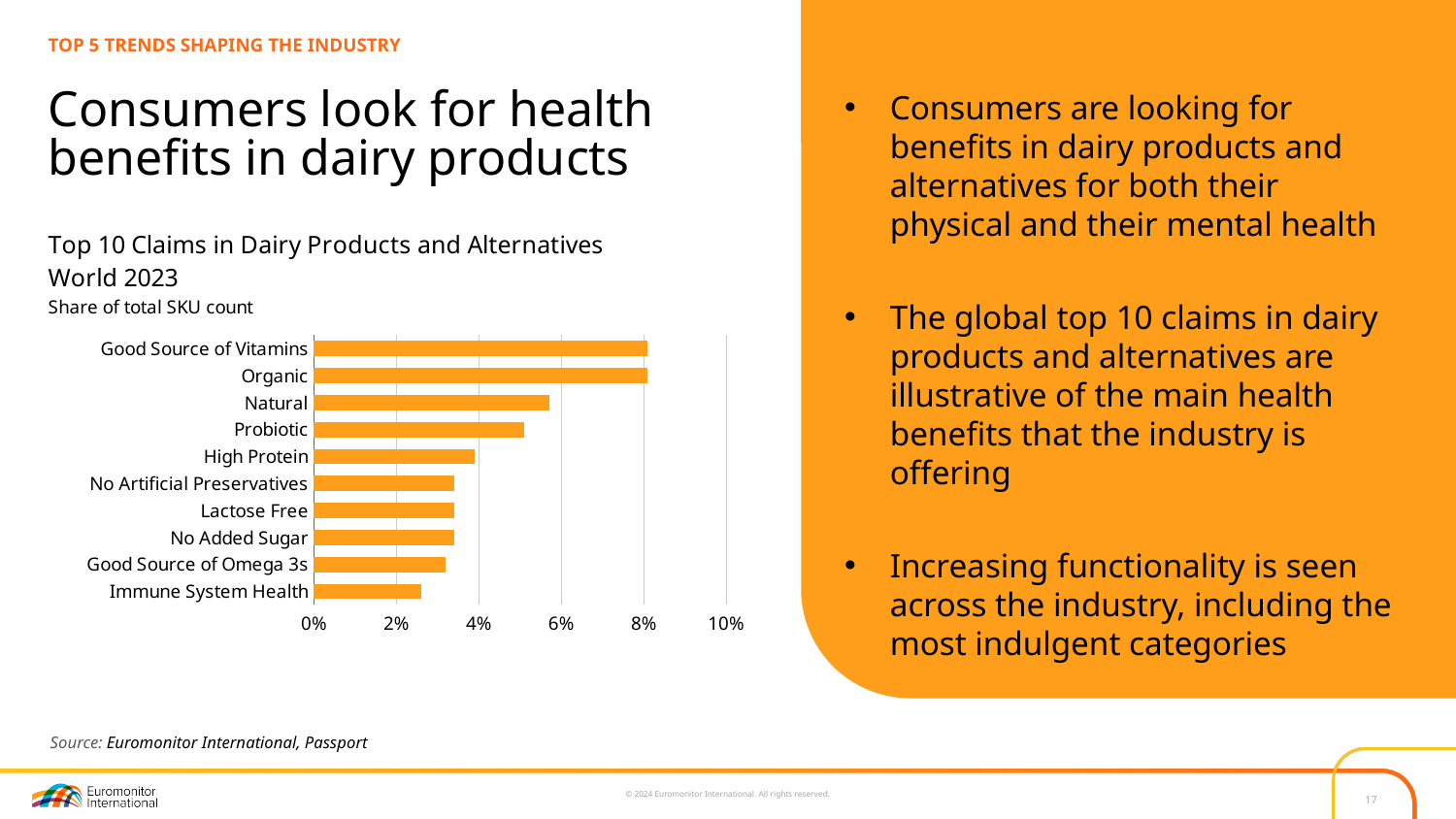
Which claim has the lowest share of total SKU count? Immune System Health Is the value for Probiotic greater or less than 6%? less Is the value for Natural greater or less than 4%? greater Is the value for Lactose Free greater or less than 2%? greater What kind of chart is shown on the slide? Bar chart What is the title of the chart? Top 10 Claims in Dairy Products and Alternatives World 2023 What measure does the chart's subtitle say the bars represent? Share of total SKU count Which has a larger share: Probiotic or Immune System Health? Probiotic Which has a larger share: Natural or High Protein? Natural How many claims are listed in the chart? 10